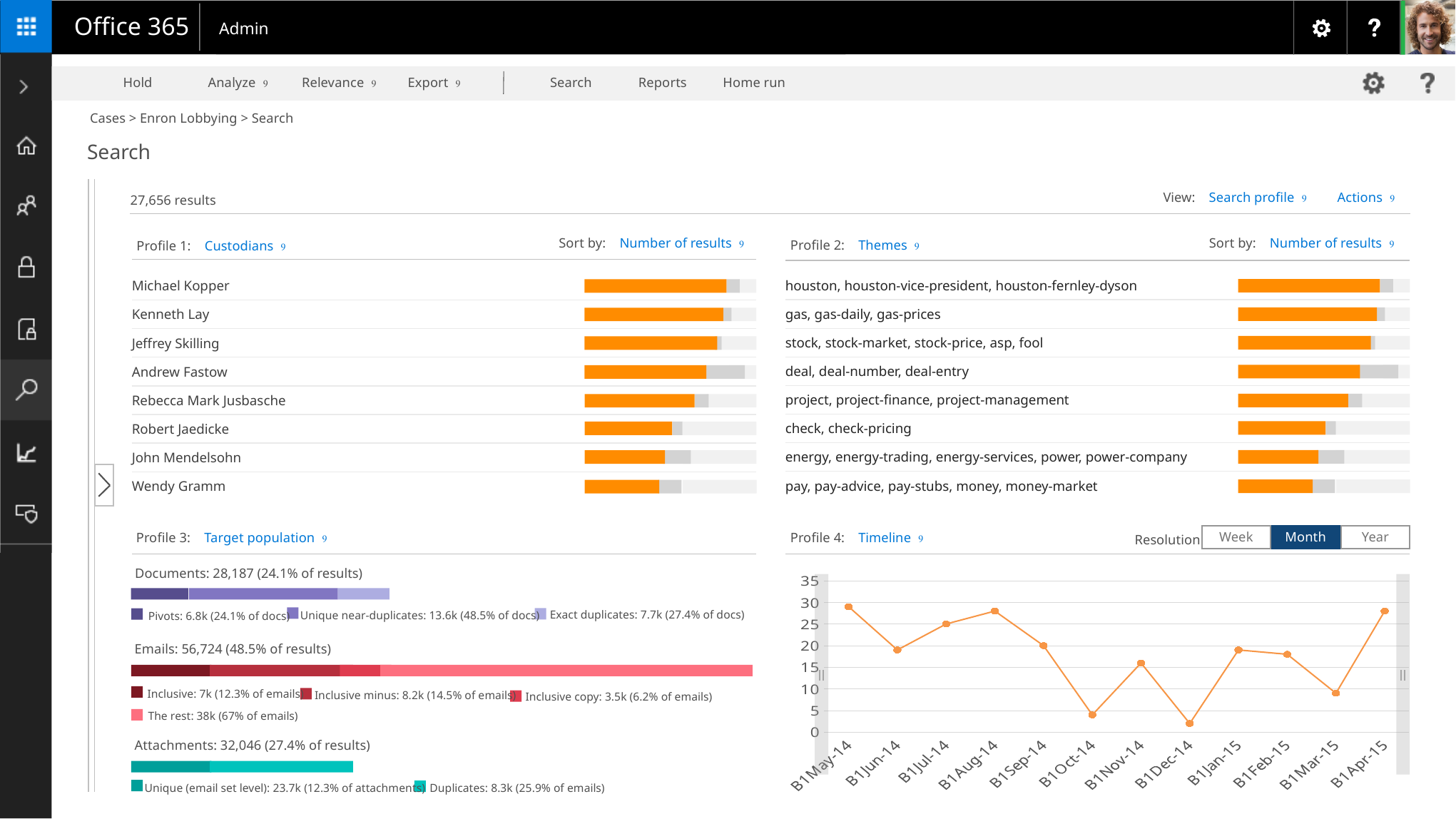
In Profile 2 (Themes), which has the longer bar: 'gas, gas-daily, gas-prices' or 'check, check-pricing'? gas, gas-daily, gas-prices In Profile 3 (Target population), what is the value for Emails? 56,724 (48.5% of results) In Profile 4 (Timeline), which month has the lowest value? B1Dec-14 In Profile 4 (Timeline), is the value for B1Oct-14 greater or less than 10? less In Profile 3 (Target population), what is the value for 'The rest' in the Emails bar? 38k (67% of emails) In Profile 1 (Custodians), how many custodians are listed? 8 In Profile 1 (Custodians), which custodian has the longest bar? Michael Kopper In Profile 3 (Target population), which of the three groups (Documents, Emails, Attachments) has the largest count? Emails What kind of chart is shown in Profile 4 (Timeline)? line chart In Profile 2 (Themes), which theme has the longest bar? houston, houston-vice-president, houston-fernley-dyson In Profile 3 (Target population), what is the value for Unique near-duplicates? 13.6k (48.5% of docs) In Profile 3 (Target population), how many documents are there? 28,187 (24.1% of results)